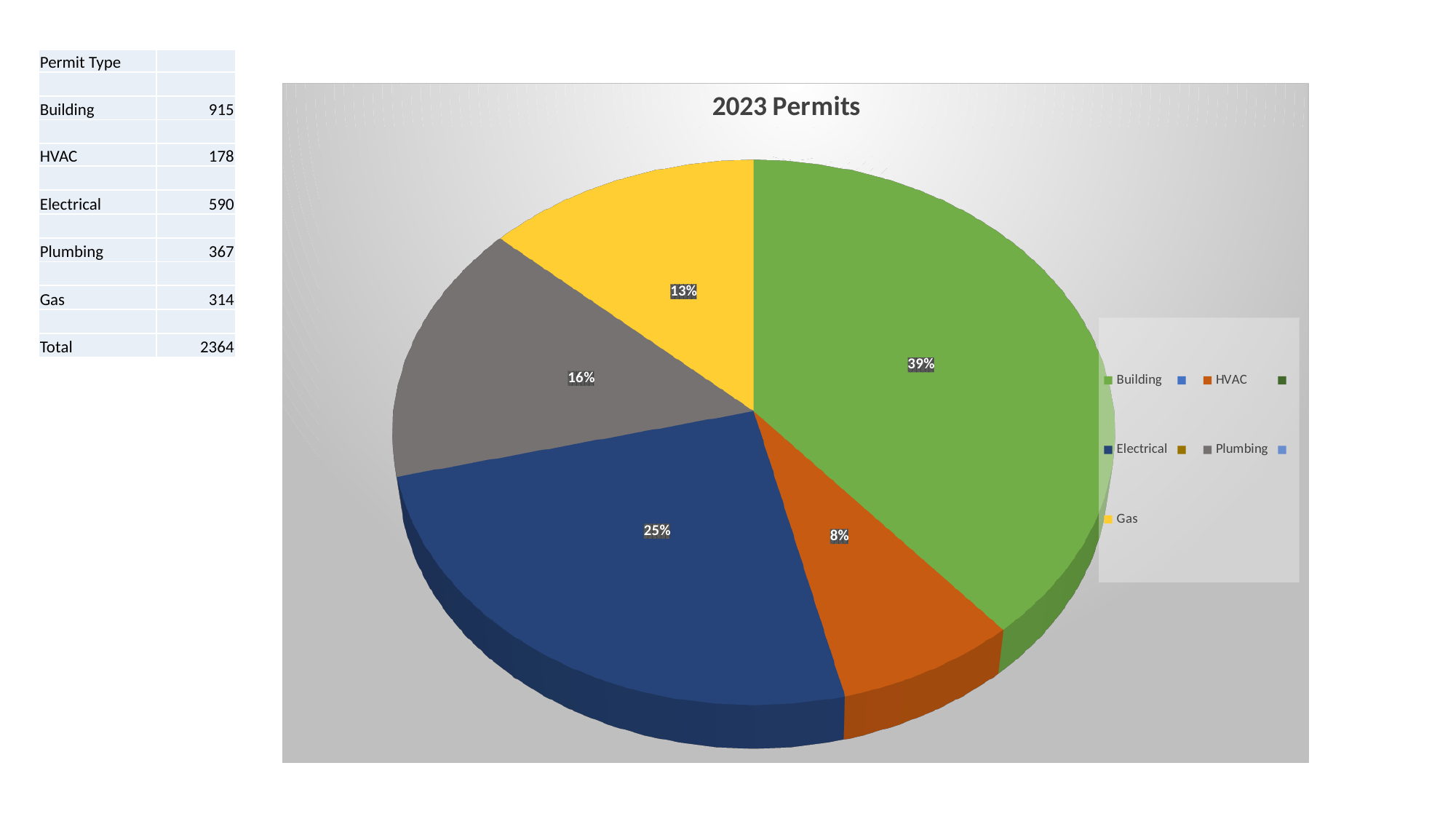
What share of the pie does Gas represent in the 2023 Permits chart? 13% What is the difference in percentage points between the Building and Electrical slices in the 2023 Permits chart? 14% Which permit type has the smallest slice in the 2023 Permits chart? HVAC What share of the pie does Plumbing represent in the 2023 Permits chart? 16% How many slices does the 2023 Permits pie chart have? 5 Which slice is larger in the 2023 Permits chart, Plumbing or Gas? Plumbing What is the title of the chart on the slide? 2023 Permits What kind of chart is shown on the slide? Pie chart What share of the pie does HVAC represent in the 2023 Permits chart? 8% Which permit type has the largest slice in the 2023 Permits chart? Building